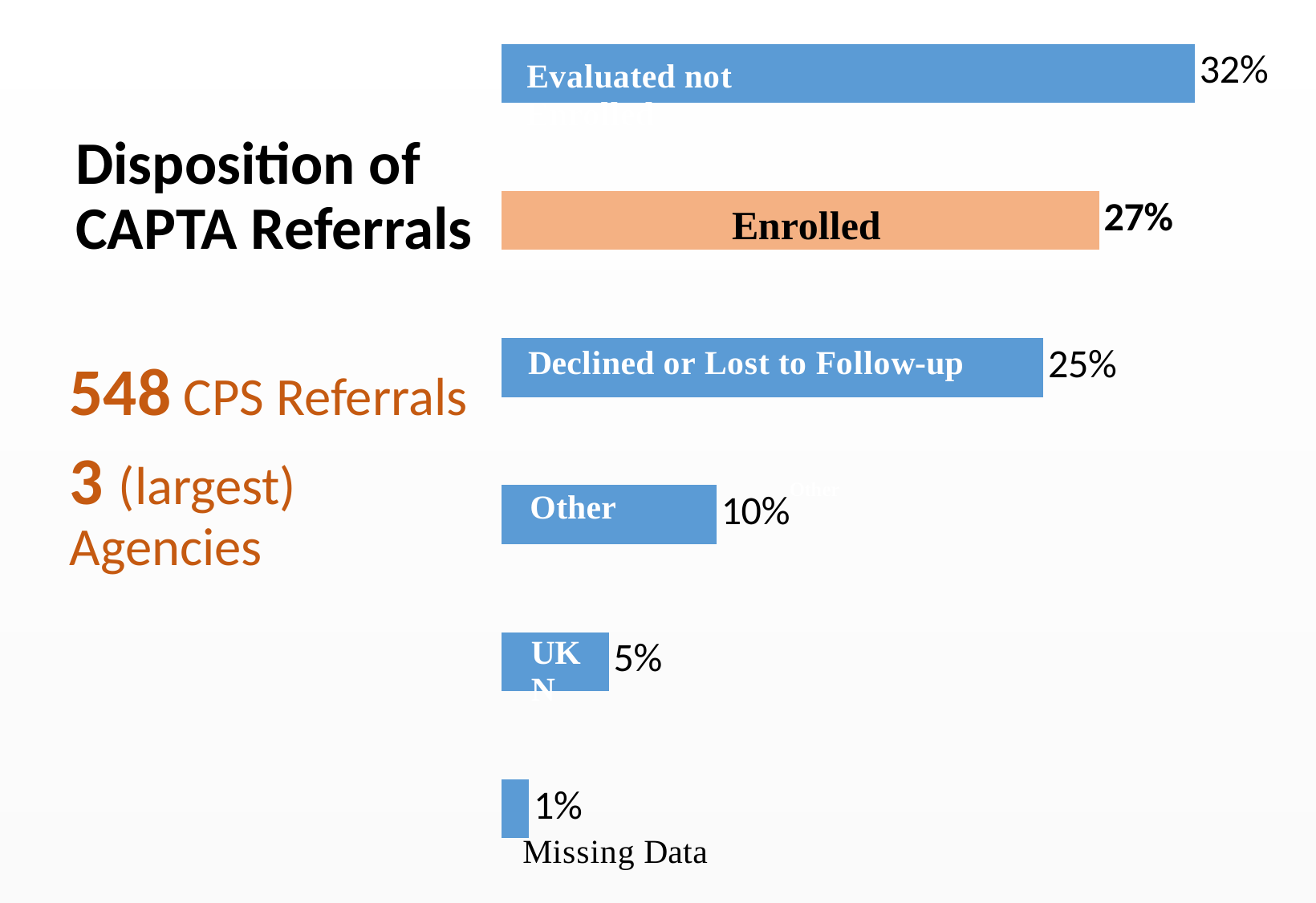
What percentage of CAPTA referrals fall under Other? 10% Which disposition category has the lowest percentage? Missing Data Which bar is shown in a different colour (orange) from the others? Enrolled Which disposition category has the highest percentage? Evaluated not enrolled How many disposition categories are shown in the chart? 6 What percentage of CAPTA referrals were Evaluated not enrolled? 32% What percentage of CAPTA referrals were Declined or Lost to Follow-up? 25% What percentage of CAPTA referrals are Missing Data? 1% What is the difference in percentage points between Evaluated not enrolled and Enrolled? 5 What kind of chart is used to show the disposition of CAPTA referrals? Bar chart What percentage of CAPTA referrals were Enrolled? 27% Which is larger, the percentage for Other or the percentage for UKN? Other